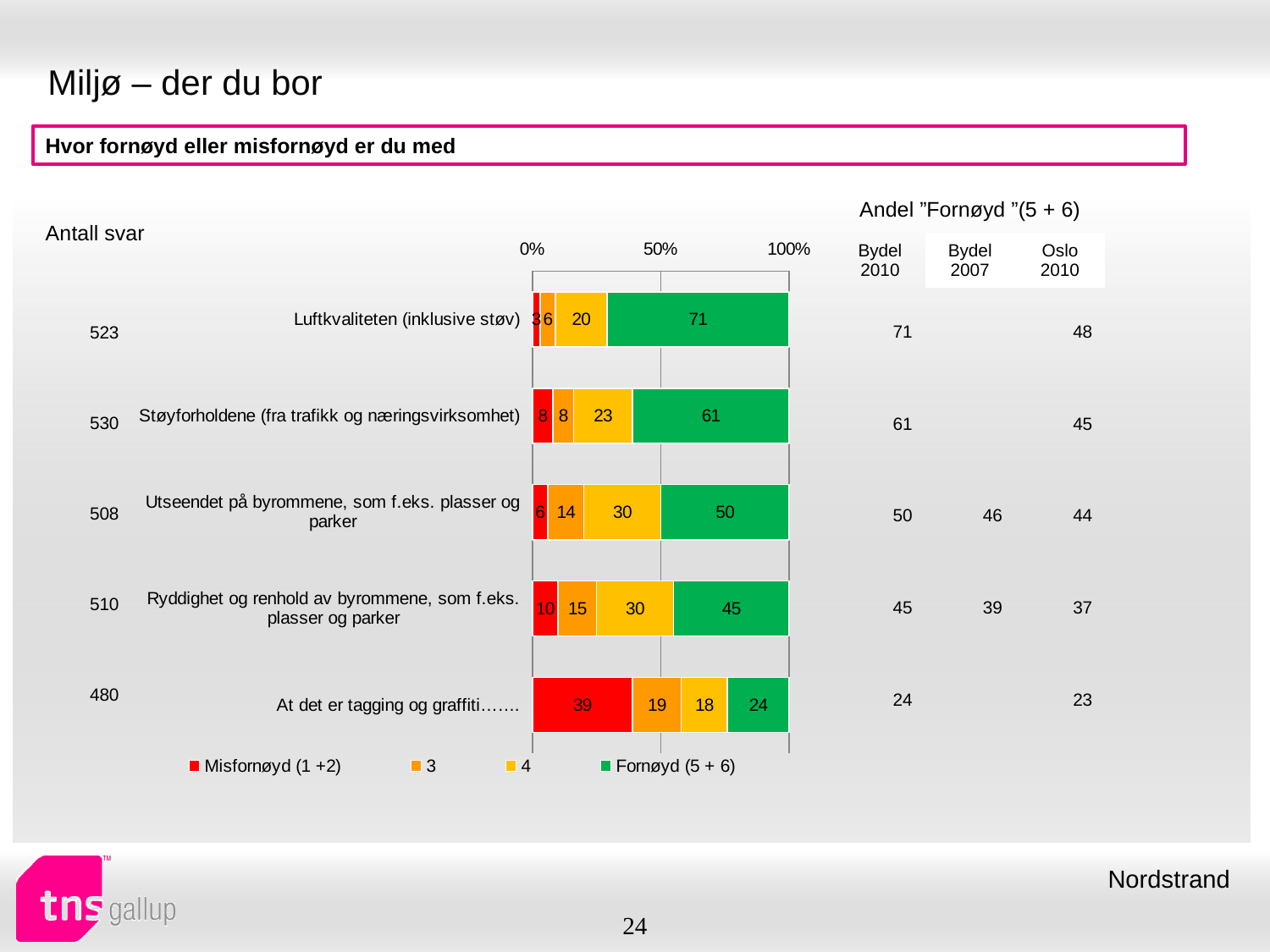
Which is larger: the Misfornøyd (1 +2) value for Ryddighet og renhold av byrommene or for Utseendet på byrommene? Ryddighet og renhold av byrommene What is the value of series 4 for Støyforholdene (fra trafikk og næringsvirksomhet)? 23 Which category has the highest Fornøyd (5 + 6) value? Luftkvaliteten (inklusive støv) Which category has the lowest Fornøyd (5 + 6) value? At det er tagging og graffiti What is the value of the Misfornøyd (1 +2) series for At det er tagging og graffiti? 39 How many categories (questions) are plotted in the chart? 5 What is the total of the stacked bar for Utseendet på byrommene, som f.eks. plasser og parker? 100 What is the difference between the Fornøyd (5 + 6) values for Støyforholdene and Ryddighet og renhold av byrommene? 16 What colour represents the Fornøyd (5 + 6) series in the chart? green What is the value of the Fornøyd (5 + 6) series for Luftkvaliteten (inklusive støv)? 71 How many series does the chart legend list? 4 What kind of chart is shown on the slide? stacked bar chart